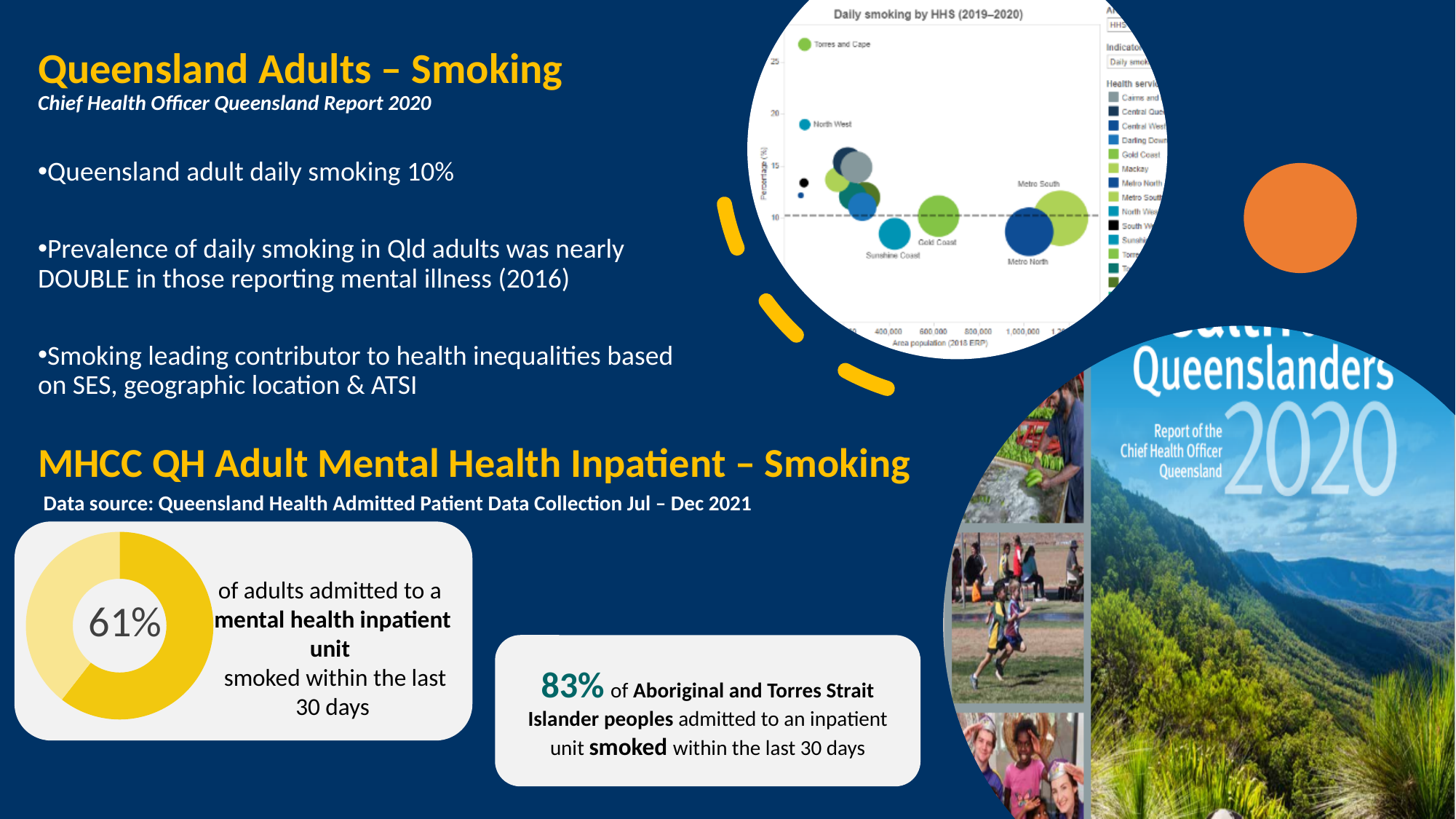
In the 'Daily smoking by HHS (2019–2020)' chart, is the daily smoking percentage for Torres and Cape greater or less than 20? greater What kind of chart is the chart at the bottom left of the slide showing 61%? Doughnut chart What kind of chart is the 'Daily smoking by HHS (2019–2020)' chart at the top of the slide? Bubble chart In the 'Daily smoking by HHS (2019–2020)' chart, which has a higher daily smoking percentage, Torres and Cape or North West? Torres and Cape In the 'Daily smoking by HHS (2019–2020)' chart, is the daily smoking percentage for North West greater or less than 15? greater What is the x-axis label of the 'Daily smoking by HHS (2019–2020)' chart? Area population (2018 ERP) What percentage is shown in the centre of the doughnut chart at the bottom left of the slide? 61% In the 'Daily smoking by HHS (2019–2020)' chart, is the daily smoking percentage for Sunshine Coast greater or less than 10? less In the 'Daily smoking by HHS (2019–2020)' chart, which HHS has the highest daily smoking percentage? Torres and Cape In the 'Daily smoking by HHS (2019–2020)' chart, which labelled HHS has the largest area population (furthest right on the x axis)? Metro South What is the title of the chart at the top of the slide? Daily smoking by HHS (2019–2020)